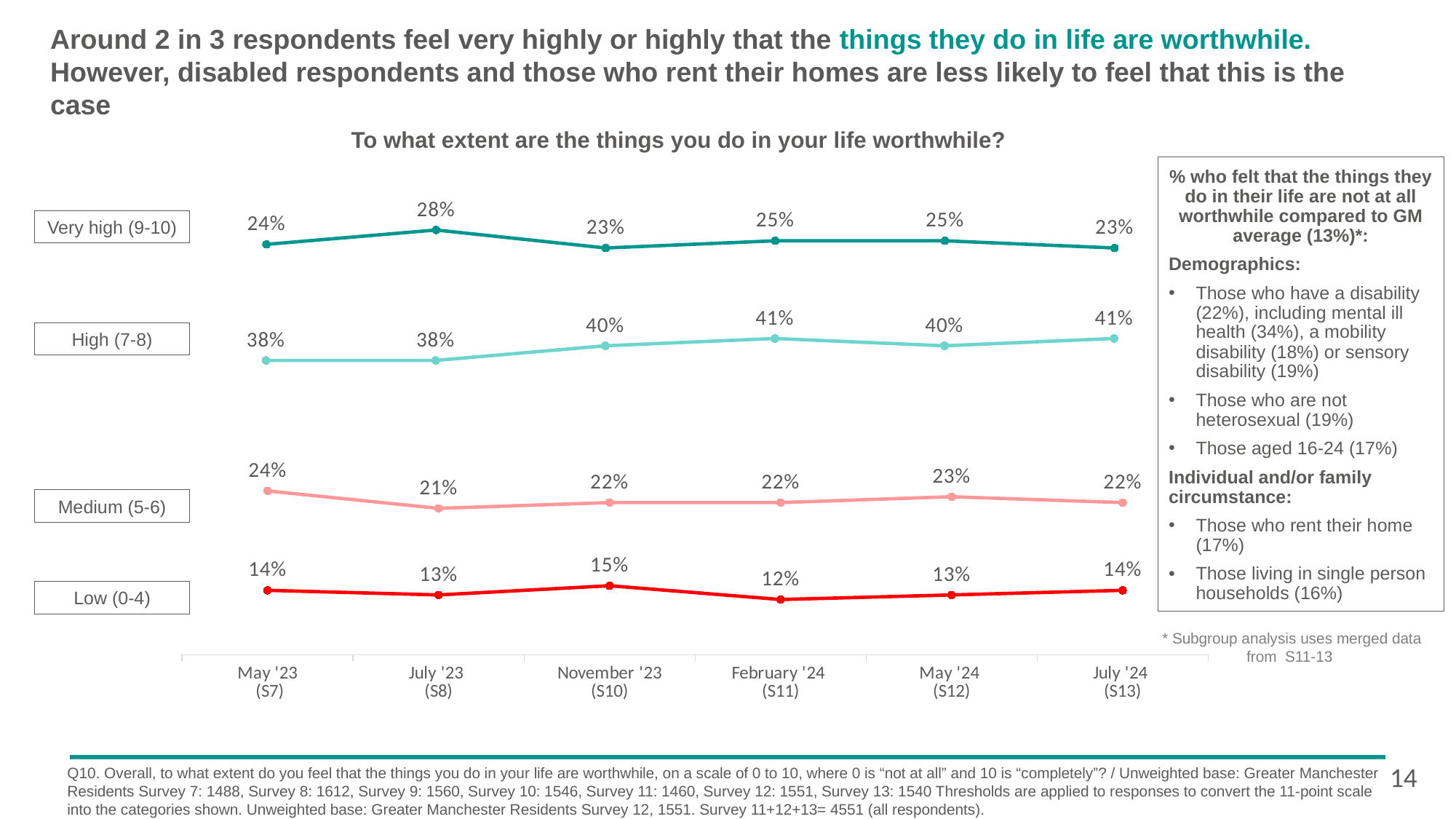
What is the value for Very high (9-10) in July '23 (S8)? 28% How many series (response categories) are plotted on the chart? 4 What is the value for Low (0-4) in February '24 (S11)? 12% What is the difference between the High (7-8) value and the Very high (9-10) value in July '24 (S13)? 18 percentage points Which is larger in May '23 (S7): the Very high (9-10) value or the Medium (5-6) value? They are equal (24%) What is the title of the chart? To what extent are the things you do in your life worthwhile? In which survey wave is the Low (0-4) value lowest? February '24 (S11) How many survey waves are plotted along the x axis? 6 What is the value for Medium (5-6) in May '23 (S7)? 24% What kind of chart is shown on the slide? Line chart In which survey wave is the Very high (9-10) value highest? July '23 (S8) What is the value for High (7-8) in July '24 (S13)? 41%